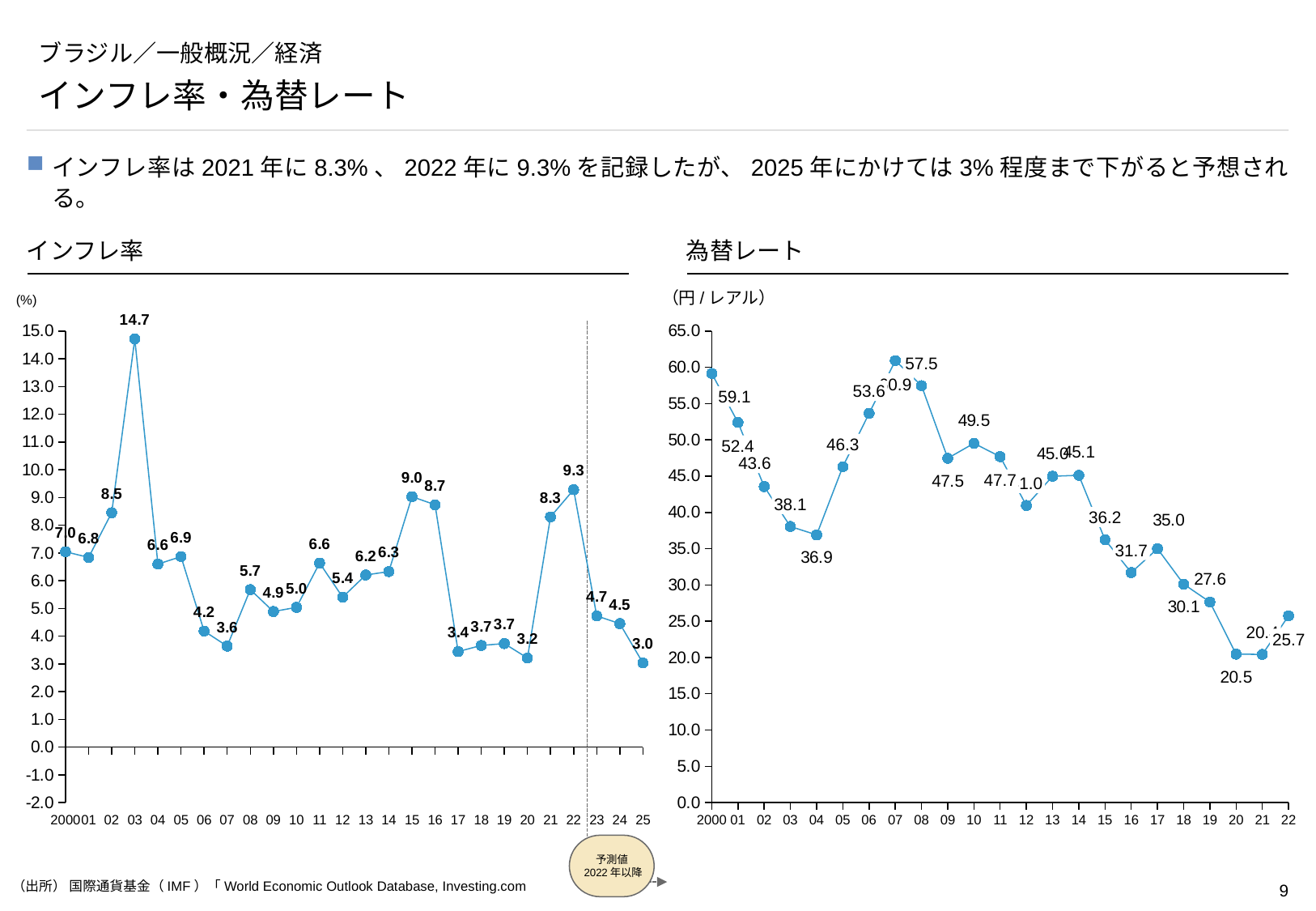
In the 為替レート chart, which is larger, the value for 2009 or the value for 2010? 2010 In the インフレ率 chart, what is the inflation rate for 2003? 14.7 In the インフレ率 chart, which year has the highest inflation rate? 2003 In the インフレ率 chart, what is the value for 2022? 9.3 In the 為替レート chart, is the value for 2012 greater or less than 40.0? greater In the インフレ率 chart, which year has the lowest value? 2025 In the 為替レート chart, what unit is shown above the y axis? 円/レアル In the 為替レート chart, what is the value for 2000? 59.1 In the 為替レート chart, what is the value for 2004? 36.9 What kind of chart is the インフレ率 chart? line chart In the 為替レート chart, which year has the highest value? 2007 In the インフレ率 chart, what is the difference between the 2022 value and the 2021 value? 1.0